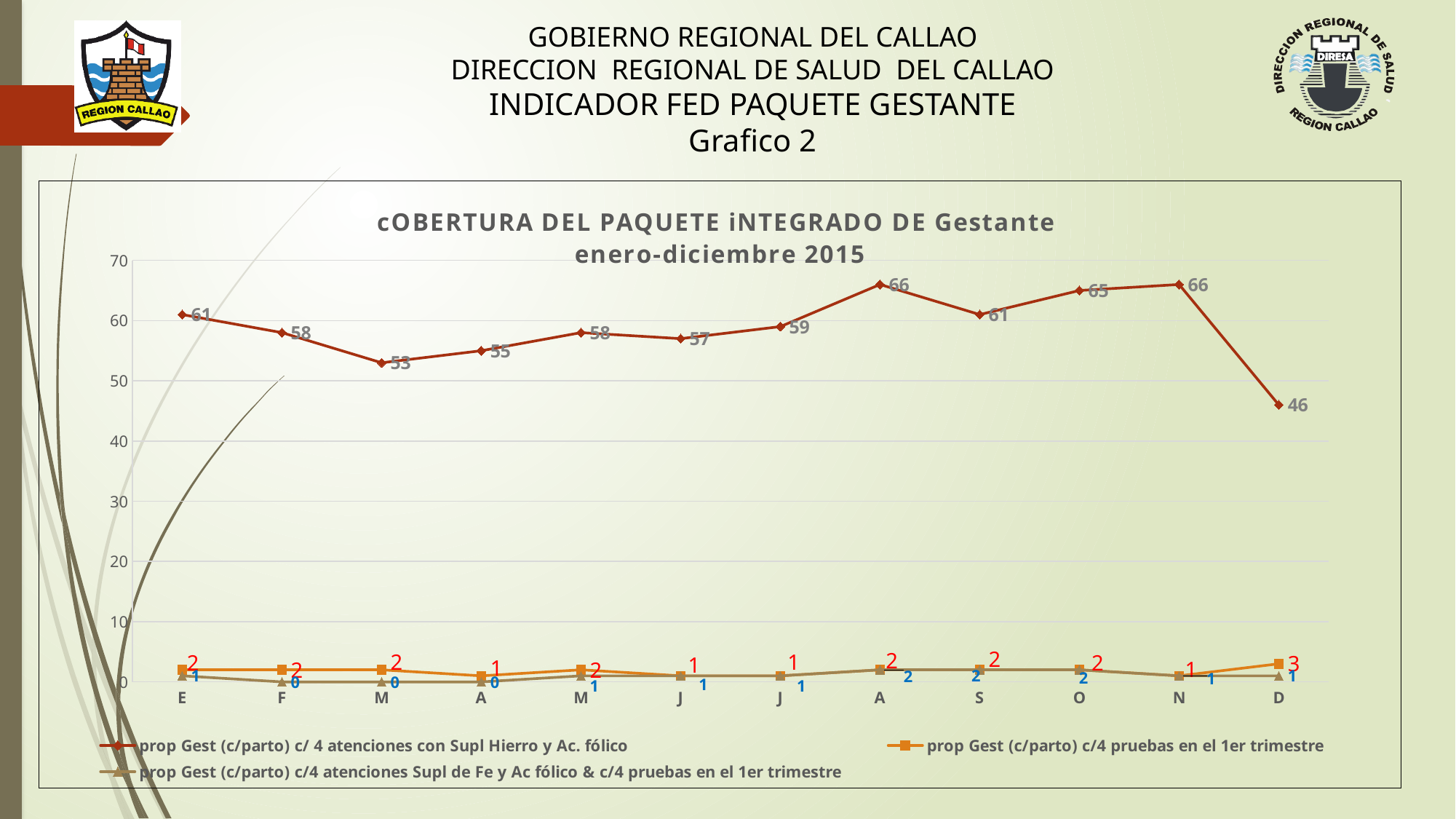
How many categories are plotted along the x axis? 12 What is the value of the series 'prop Gest (c/parto) c/ 4 atenciones con Supl Hierro y Ac. fólico' for E? 61 For which category is the series 'prop Gest (c/parto) c/4 pruebas en el 1er trimestre' highest? D What is the difference between the values for N and D in the series 'prop Gest (c/parto) c/ 4 atenciones con Supl Hierro y Ac. fólico'? 20 How many series does the legend list? 3 In the series 'prop Gest (c/parto) c/ 4 atenciones con Supl Hierro y Ac. fólico', which is larger, the value for O or the value for S? O Is the value for F in the series 'prop Gest (c/parto) c/ 4 atenciones con Supl Hierro y Ac. fólico' greater or less than 50? greater What kind of chart is shown on the slide? line chart For which category is the series 'prop Gest (c/parto) c/ 4 atenciones con Supl Hierro y Ac. fólico' lowest? D What is the value of the series 'prop Gest (c/parto) c/ 4 atenciones con Supl Hierro y Ac. fólico' for S? 61 Does the series 'prop Gest (c/parto) c/ 4 atenciones con Supl Hierro y Ac. fólico' rise or fall from N to D? fall What is the value of the series 'prop Gest (c/parto) c/ 4 atenciones con Supl Hierro y Ac. fólico' for D? 46